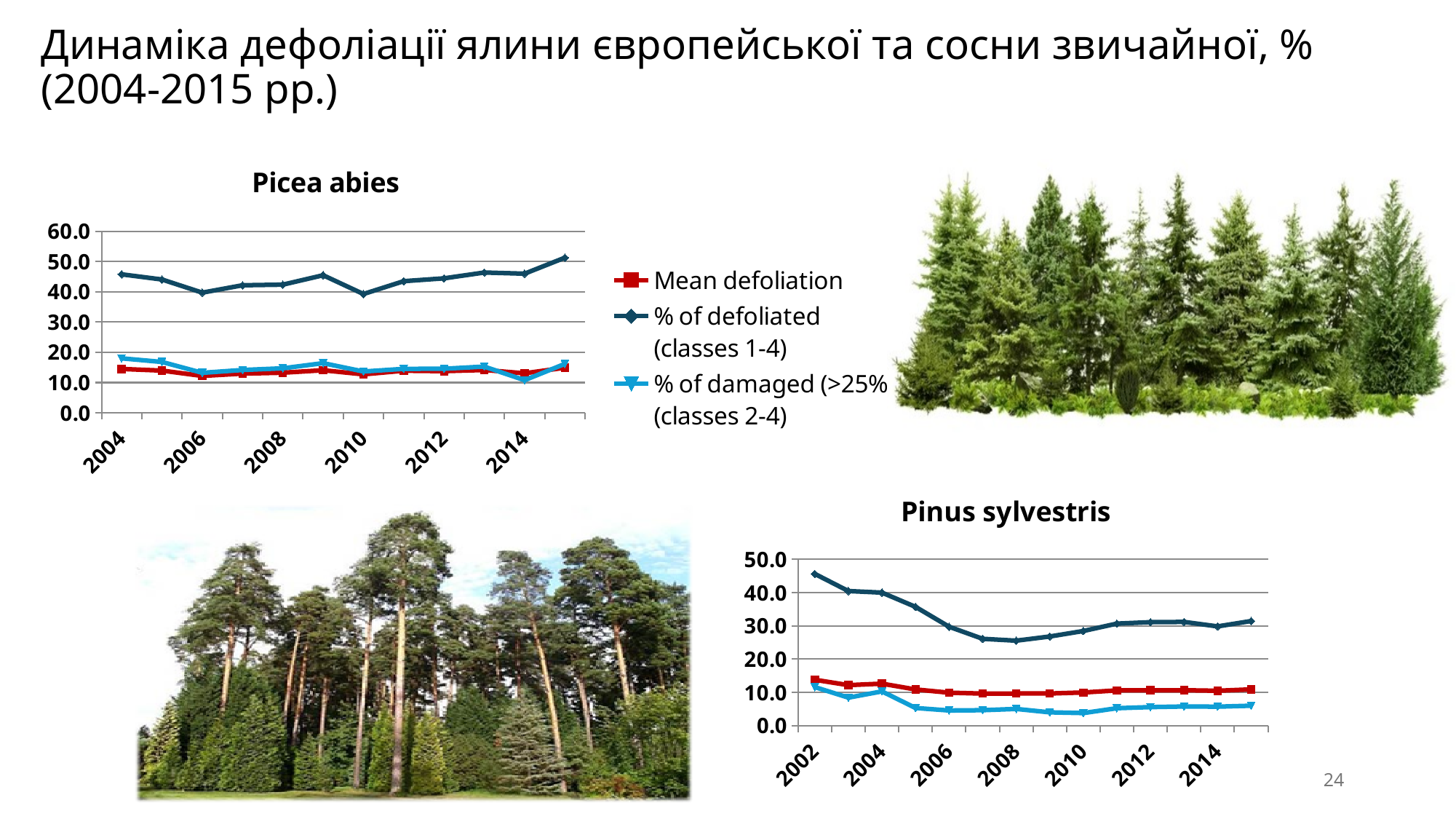
In the 'Pinus sylvestris' chart, is the value of '% of defoliated (classes 1-4)' in 2002 greater or less than 40? greater In the 'Pinus sylvestris' chart, is the value of 'Mean defoliation' or '% of damaged (>25%) (classes 2-4)' larger in 2010? Mean defoliation How many series does the legend list for the charts? 3 In the 'Picea abies' chart, which year has the highest value of '% of defoliated (classes 1-4)'? 2015 What kind of chart is the 'Picea abies' chart? line chart In the 'Pinus sylvestris' chart, which year has the highest value of '% of defoliated (classes 1-4)'? 2002 In the 'Pinus sylvestris' chart, is the value of '% of defoliated (classes 1-4)' in 2008 greater or less than 30? less In the 'Picea abies' chart, is the value of '% of defoliated (classes 1-4)' larger in 2015 or in 2010? 2015 What is the title of the chart in the lower right of the slide? Pinus sylvestris In the 'Pinus sylvestris' chart, does the '% of defoliated (classes 1-4)' series rise or fall from 2002 to 2008? fall In the 'Picea abies' chart, is the value of '% of defoliated (classes 1-4)' in 2015 greater or less than 40? greater